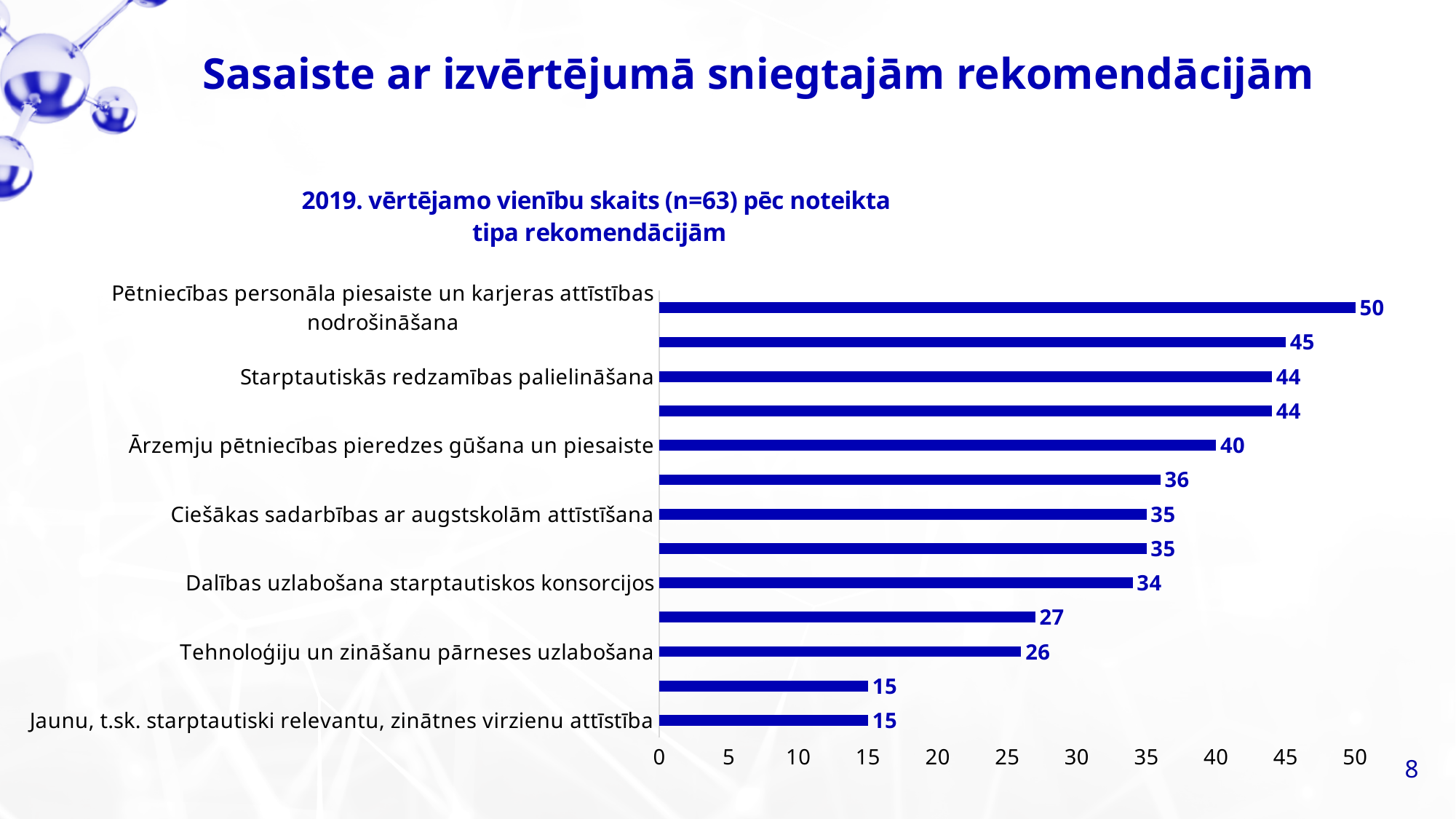
Which category has the highest value? Pētniecības personāla piesaiste un karjeras attīstības nodrošināšana Which is larger: the value for "Ciešākas sadarbības ar augstskolām attīstīšana" or the value for "Tehnoloģiju un zināšanu pārneses uzlabošana"? Ciešākas sadarbības ar augstskolām attīstīšana How many bars are plotted on the chart? 13 What is the value for "Starptautiskās redzamības palielināšana"? 44 What is the value for "Ārzemju pētniecības pieredzes gūšana un piesaiste"? 40 What is the value for "Pētniecības personāla piesaiste un karjeras attīstības nodrošināšana"? 50 What is the value for "Jaunu, t.sk. starptautiski relevantu, zinātnes virzienu attīstība"? 15 What is the value for "Tehnoloģiju un zināšanu pārneses uzlabošana"? 26 What is the difference between the values for "Pētniecības personāla piesaiste un karjeras attīstības nodrošināšana" and "Starptautiskās redzamības palielināšana"? 6 What kind of chart is shown on the slide? Bar chart What is the difference between the values for "Ārzemju pētniecības pieredzes gūšana un piesaiste" and "Tehnoloģiju un zināšanu pārneses uzlabošana"? 14 What is the lowest value shown on the chart? 15